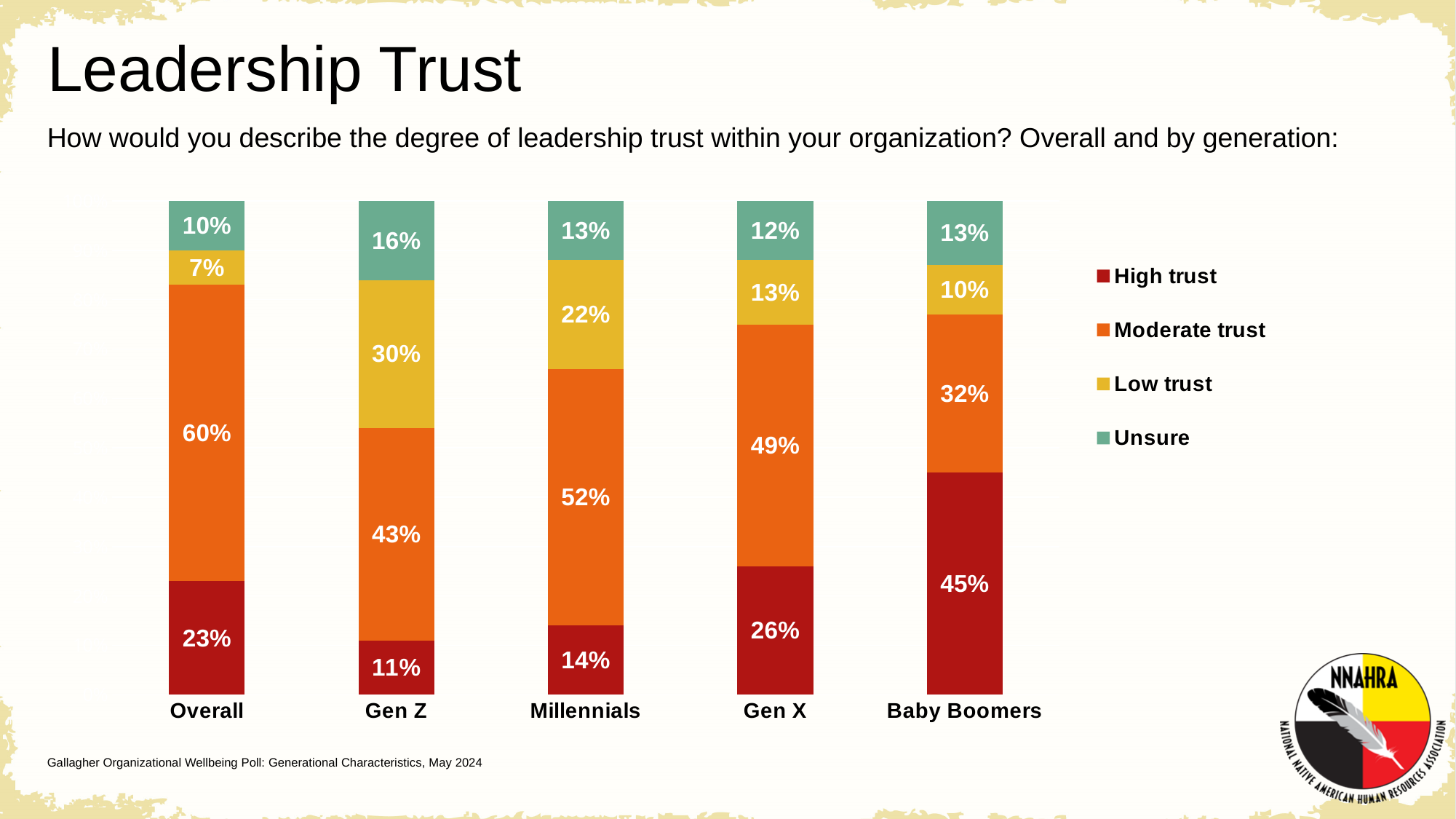
What kind of chart is shown on the slide? Stacked bar chart What is the Low trust value for the Overall group? 7% Which category has the highest Low trust percentage? Gen Z What percentage of Baby Boomers report high trust? 45% How many series does the legend list? 4 Which category has the lowest High trust percentage? Gen Z What is the difference between the Moderate trust values for Overall and Baby Boomers? 28% Which is larger: the High trust value for Gen X or for Millennials? Gen X What percentage of Millennials are Unsure? 13% What is the Moderate trust value for Gen Z? 43% How many categories are shown on the x axis? 5 Which generation has the highest High trust percentage? Baby Boomers